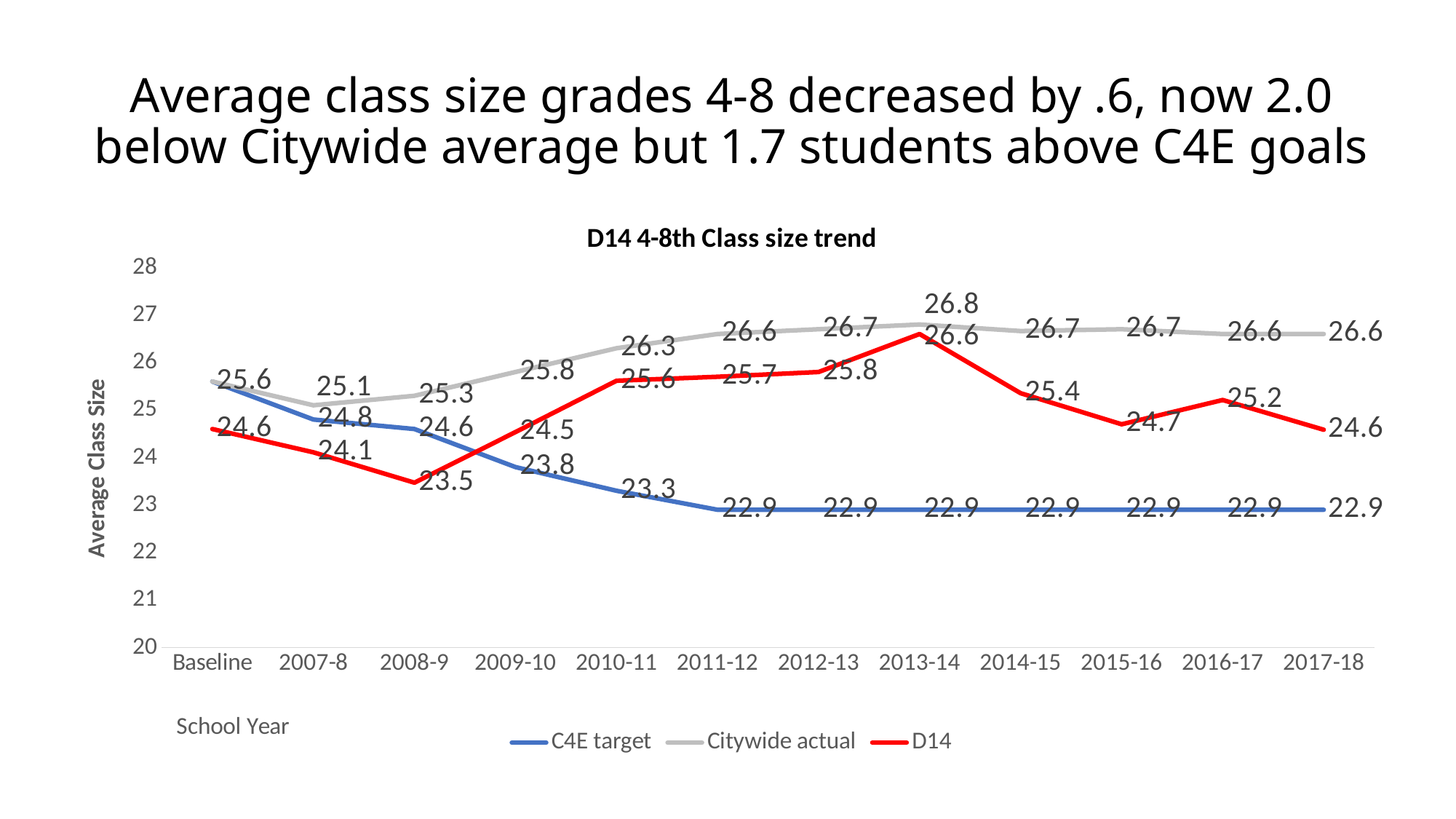
What is the difference between the Citywide actual and D14 values in 2017-18? 2.0 In which school year is the D14 value highest? 2013-14 What is the title of the chart? D14 4-8th Class size trend What is the Citywide actual value for 2013-14? 26.8 Does the C4E target series rise or fall from Baseline to 2011-12? fall What is the D14 value for 2017-18? 24.6 How many school-year points are plotted along the x axis? 12 In 2008-9, which is larger: the D14 value or the C4E target value? C4E target What kind of chart is shown on the slide? line chart How many series does the legend list? 3 In which school year is the D14 value lowest? 2008-9 What is the C4E target value for 2010-11? 23.3